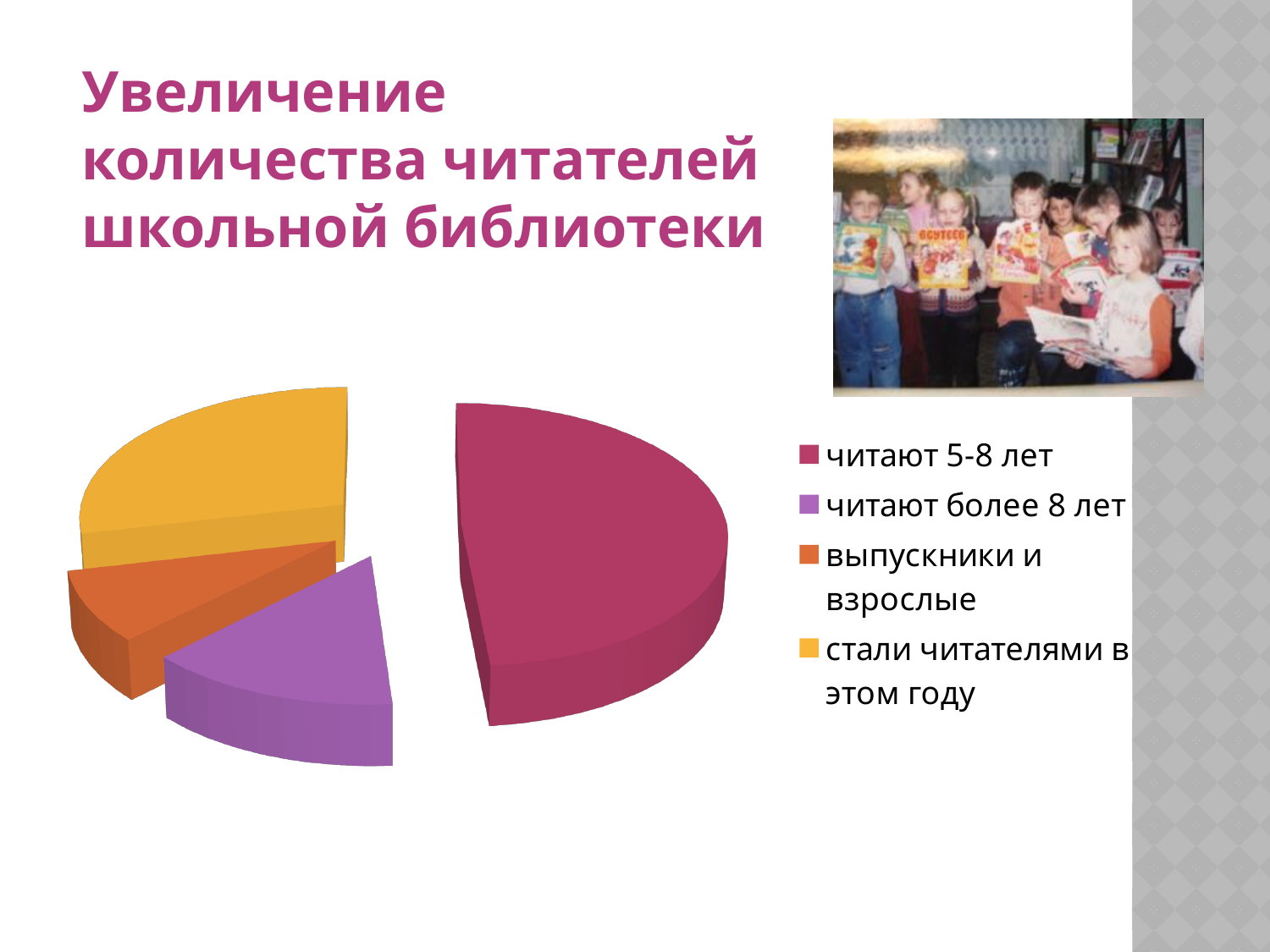
How many entries does the legend of the pie chart list? 4 What kind of chart is shown on the slide? pie chart Which slice is larger: "читают 5-8 лет" or "читают более 8 лет"? читают 5-8 лет How many slices does the pie chart have? 4 Which slice is larger: "читают более 8 лет" or "выпускники и взрослые"? читают более 8 лет Which category has the smallest slice of the pie chart? выпускники и взрослые What colour is the slice for "стали читателями в этом году"? yellow What is the title of the slide containing the pie chart? Увеличение количества читателей школьной библиотеки Which category has the largest slice of the pie chart? читают 5-8 лет Which slice is larger: "стали читателями в этом году" or "выпускники и взрослые"? стали читателями в этом году